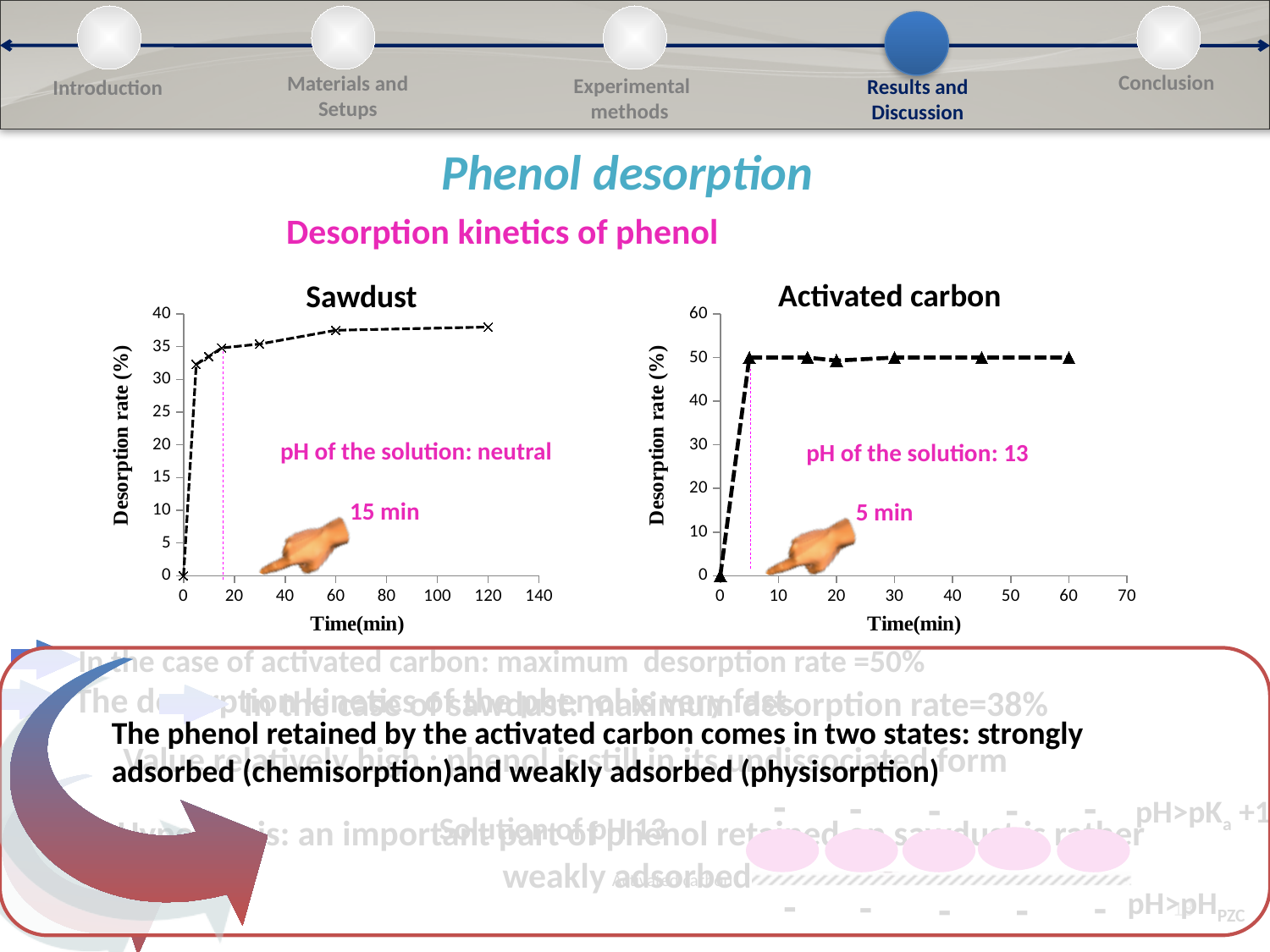
In the Activated carbon chart, does the desorption rate rise or fall between 0 and 5 min? rise What is the x-axis title of the Activated carbon chart? Time(min) In the Sawdust chart, does the desorption rate rise or fall from 5 min to 120 min? rise In the Activated carbon chart, what is the desorption rate at time 0? 0 In the Activated carbon chart, is the desorption rate at 60 min greater or less than 40? greater In the Sawdust chart, what is the desorption rate at time 0? 0 In the Sawdust chart, is the desorption rate at 120 min greater or less than 35? greater What pH of the solution is noted on the Activated carbon chart? 13 How many data points are plotted in the Sawdust chart? 7 In the Activated carbon chart, is the desorption rate at 30 min greater or less than 40? greater What kind of chart is the Sawdust chart? line chart